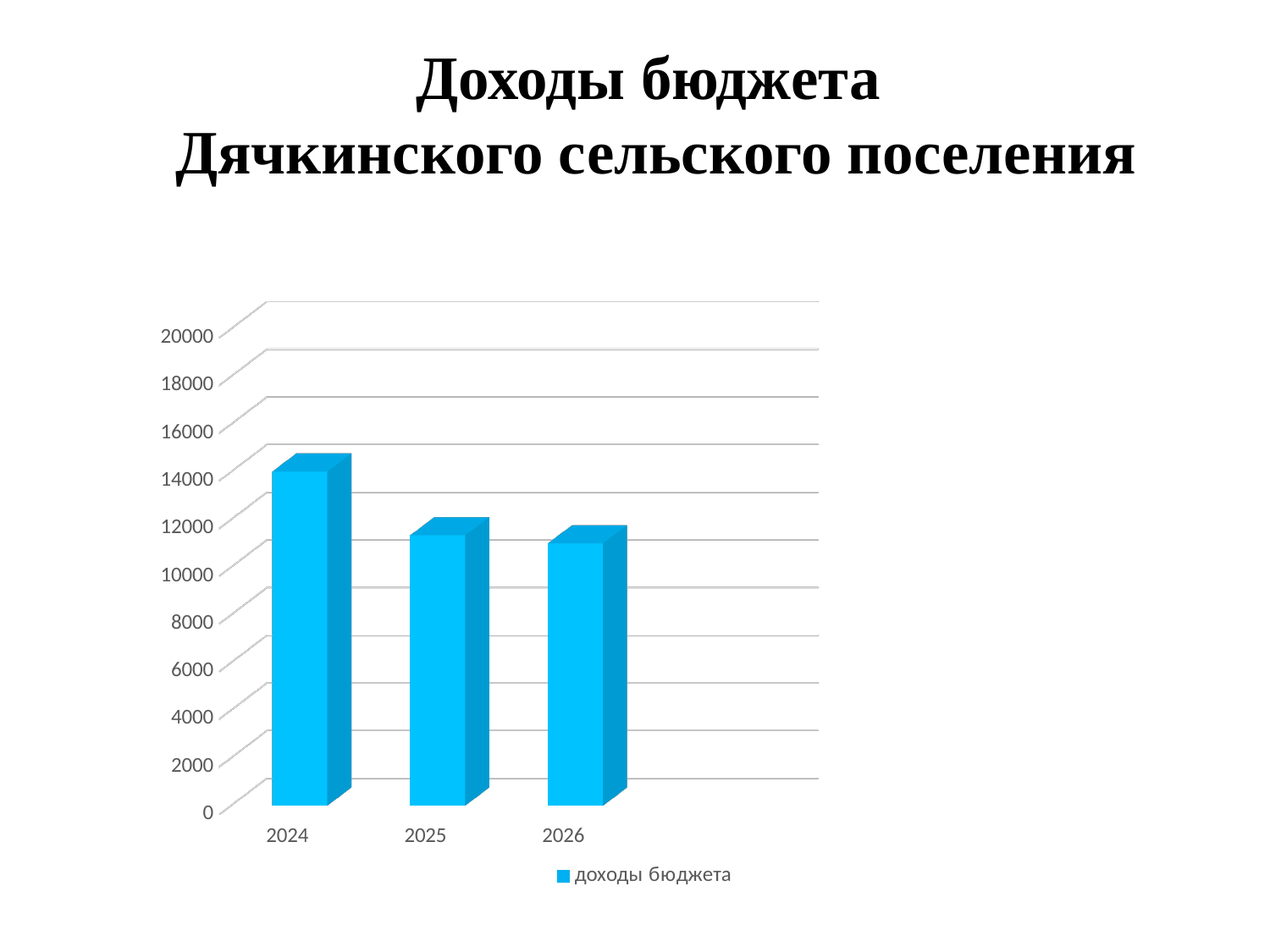
Is the value for 2024 greater or less than 12000? greater Do the values rise or fall from 2024 to 2026? fall Is the value for 2026 greater or less than 12000? less How many years are shown on the x axis of the chart? 3 What is the name of the series shown in the chart legend? доходы бюджета Which is larger, the value for 2024 or the value for 2026? 2024 Which year has the highest budget revenue in the chart? 2024 What kind of chart is shown on the slide? bar chart Is the value for 2025 greater or less than 14000? less What is the title of the slide containing the chart? Доходы бюджета Дячкинского сельского поселения How many series does the chart legend list? 1